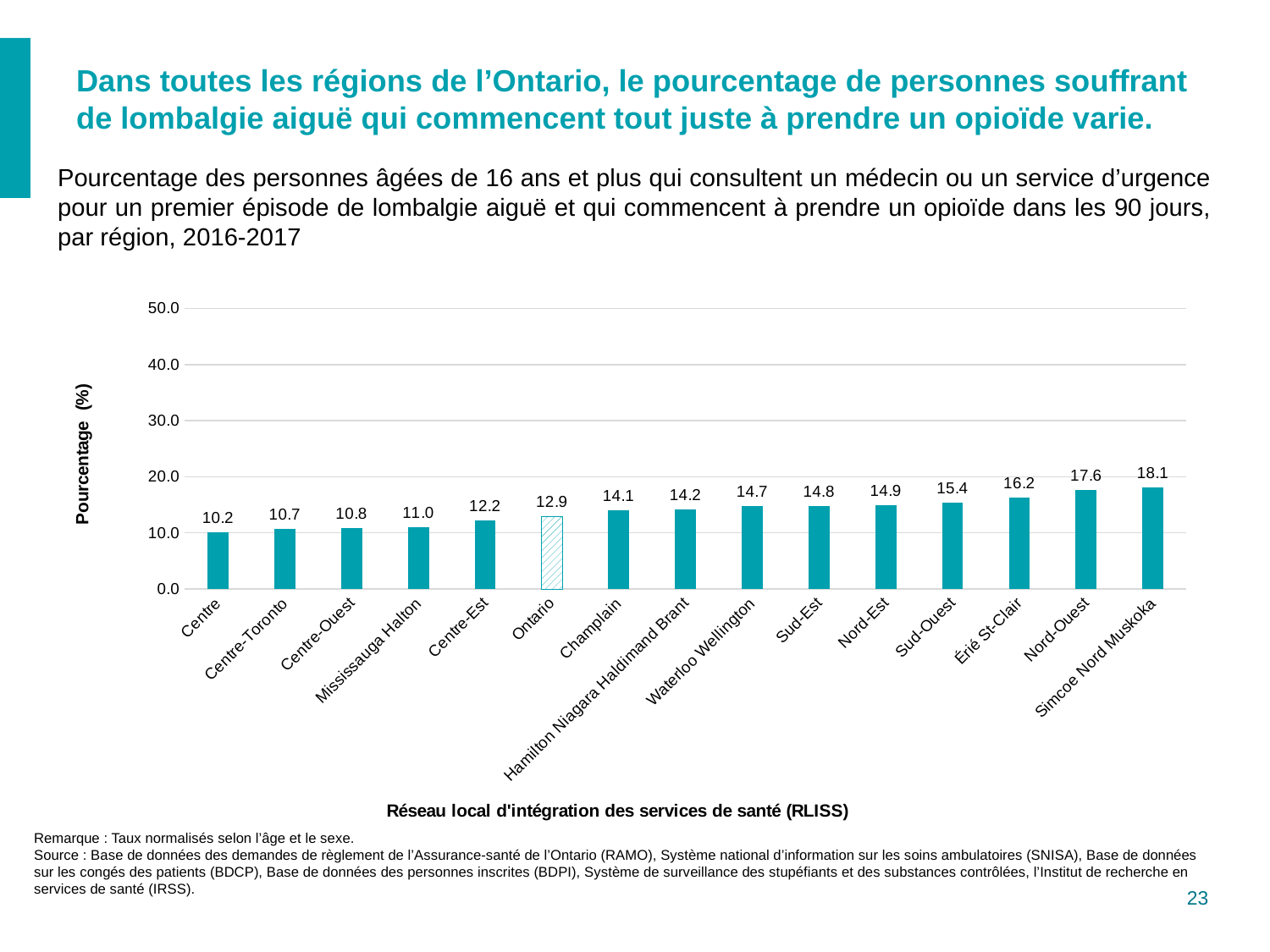
Which region has the lowest value? Centre Which is larger, the value for Champlain or the value for Centre-Est? Champlain What kind of chart is shown on the slide? Bar chart What is the value for Ontario? 12.9 What is the label of the x axis? Réseau local d'intégration des services de santé (RLISS) What is the value for Centre-Toronto? 10.7 How many bars are shown in the chart? 15 Which region has the highest value? Simcoe Nord Muskoka Is the value for Sud-Ouest greater or less than 20.0? less What is the difference between the values for Nord-Ouest and Ontario? 4.7 What is the value for Érié St-Clair? 16.2 What is the difference between the values for Simcoe Nord Muskoka and Centre? 7.9